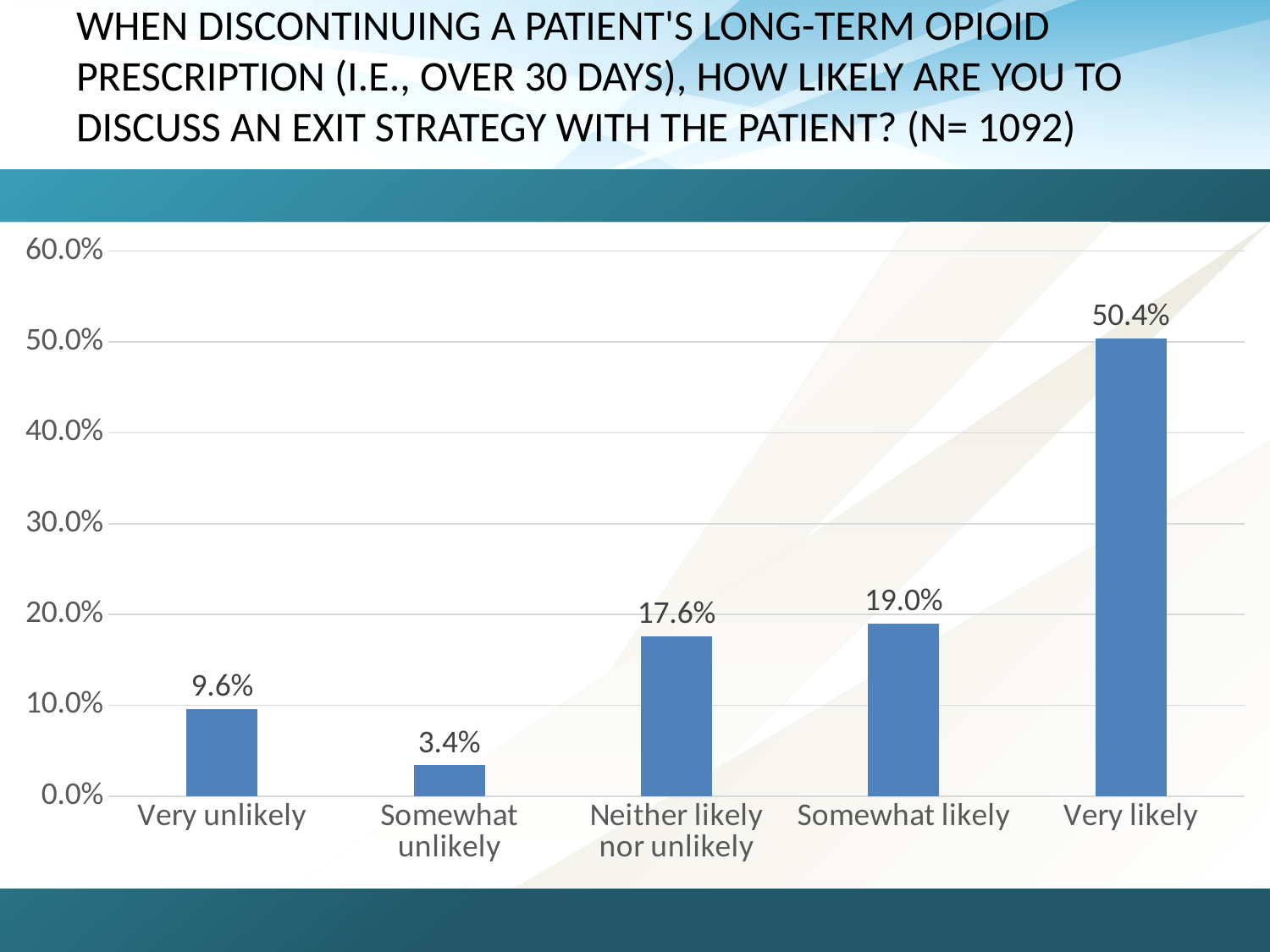
What is the value for "Neither likely nor unlikely"? 17.6% What kind of chart is shown on the slide? Bar chart Which category has the highest value? Very likely What is the sample size (N) stated in the slide title? 1092 Which is larger, the value for "Somewhat likely" or the value for "Neither likely nor unlikely"? Somewhat likely Which category has the lowest value? Somewhat unlikely Is the value for "Very likely" greater or less than 40.0%? greater What is the value for "Somewhat unlikely"? 3.4% What is the difference between the values for "Very likely" and "Somewhat likely"? 31.4% What percentage of respondents answered "Very likely"? 50.4% What is the difference between the values for "Very unlikely" and "Somewhat unlikely"? 6.2% How many categories are shown on the x axis? 5